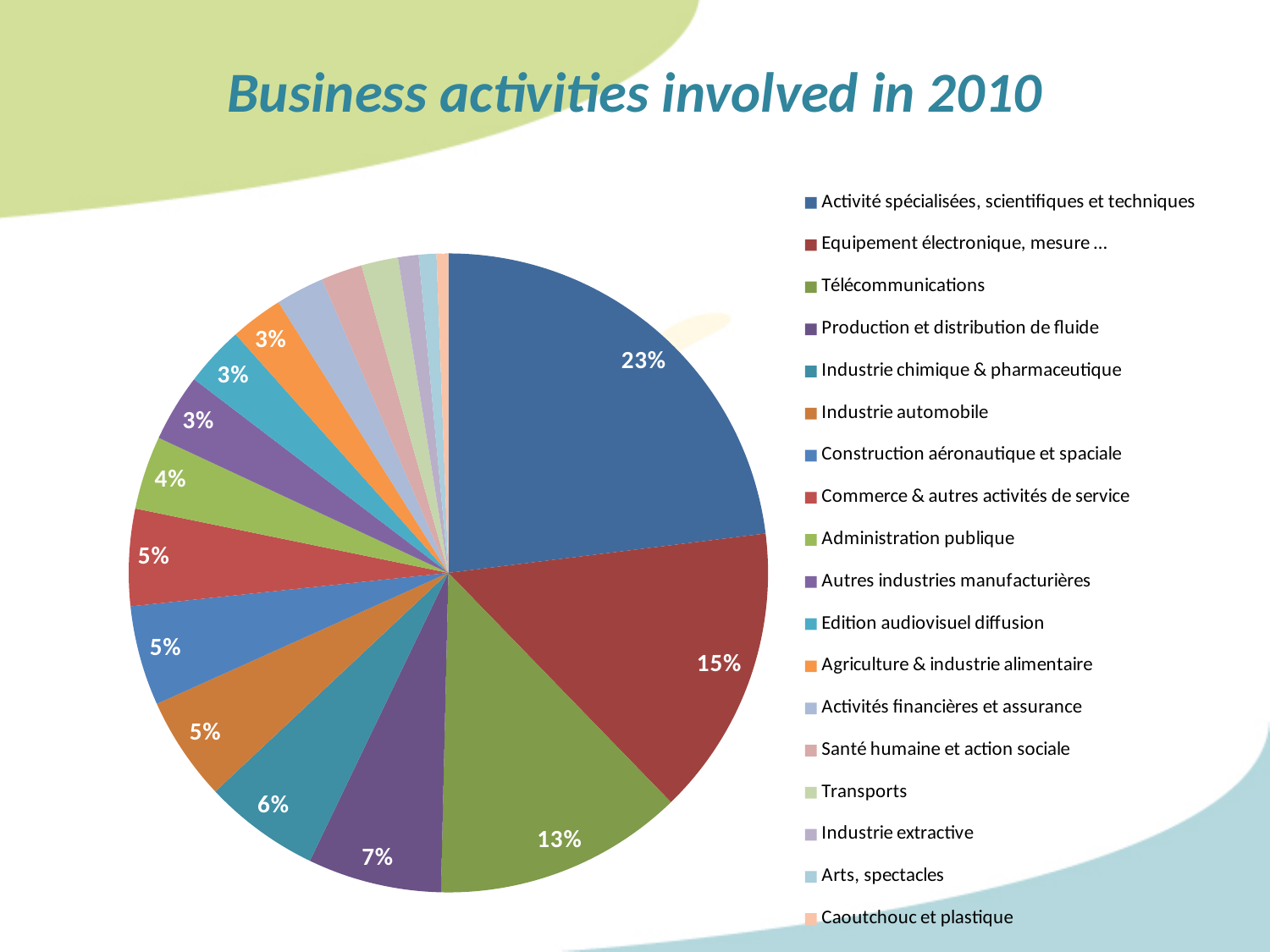
What is the difference in percentage points between Activité spécialisées, scientifiques et techniques and Equipement électronique, mesure …? 8 percentage points What share of the pie does Production et distribution de fluide have? 7% What share of the pie does Activité spécialisées, scientifiques et techniques have? 23% What kind of chart is shown on the slide? pie chart Which category has the largest share of the pie? Activité spécialisées, scientifiques et techniques Which is larger, the share for Télécommunications or the share for Production et distribution de fluide? Télécommunications What share of the pie does Equipement électronique, mesure … have? 15% How many categories does the legend list? 18 What share of the pie does Administration publique have? 4% What share of the pie does Télécommunications have? 13% What share of the pie does Industrie chimique & pharmaceutique have? 6% What is the title of the chart? Business activities involved in 2010